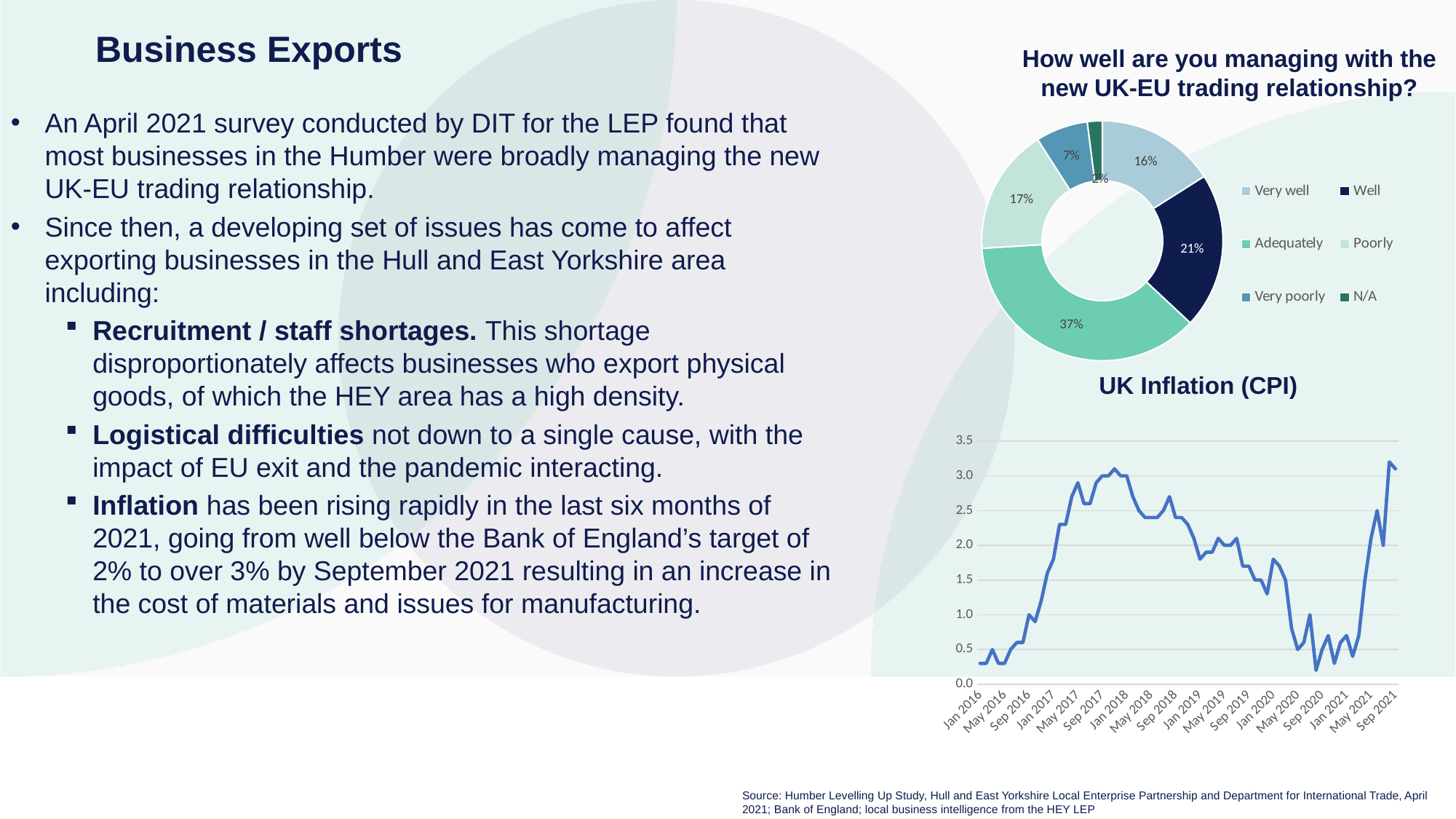
In the chart 'How well are you managing with the new UK-EU trading relationship?', which is larger: the share for 'Well' or the share for 'Very well'? Well In the chart 'How well are you managing with the new UK-EU trading relationship?', what is the difference in percentage points between 'Well' and 'Poorly'? 4 In the 'UK Inflation (CPI)' chart, is the value for Jan 2016 greater or less than 0.5? less In the 'UK Inflation (CPI)' chart, is the value for Sep 2021 greater or less than 3.0? greater In the chart 'How well are you managing with the new UK-EU trading relationship?', what percentage of respondents answered 'Very poorly'? 7% In the chart 'How well are you managing with the new UK-EU trading relationship?', what percentage of respondents answered 'Adequately'? 37% In the chart 'How well are you managing with the new UK-EU trading relationship?', which response category has the smallest share? N/A What kind of chart is 'UK Inflation (CPI)'? Line chart How many response categories does the legend of the chart 'How well are you managing with the new UK-EU trading relationship?' list? 6 What kind of chart is 'How well are you managing with the new UK-EU trading relationship?'? Doughnut chart In the chart 'How well are you managing with the new UK-EU trading relationship?', which response category has the largest share? Adequately In the chart 'How well are you managing with the new UK-EU trading relationship?', what percentage of respondents answered 'Very well'? 16%